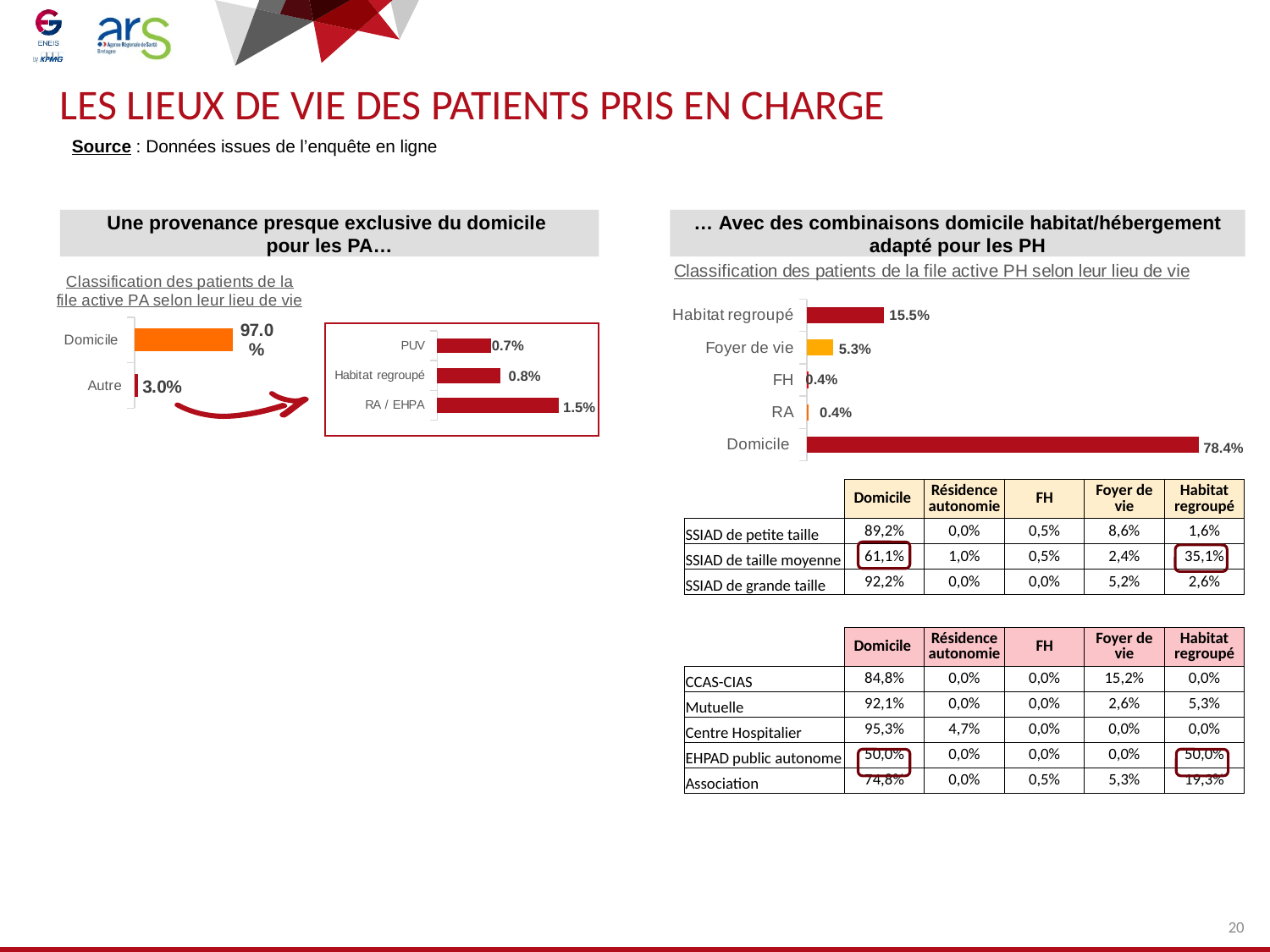
In the chart 'Classification des patients de la file active PA selon leur lieu de vie', what is the value for Autre? 3.0% In the chart 'Classification des patients de la file active PH selon leur lieu de vie', which category has the highest value? Domicile What kind of chart is 'Classification des patients de la file active PH selon leur lieu de vie'? Bar chart In the chart 'Classification des patients de la file active PA selon leur lieu de vie', what is the value for Domicile? 97.0% In the chart 'Classification des patients de la file active PH selon leur lieu de vie', what is the value for Foyer de vie? 5.3% In the small inset chart on the left, which is larger: Habitat regroupé or RA / EHPA? RA / EHPA In the chart 'Classification des patients de la file active PH selon leur lieu de vie', how many categories are shown? 5 In the chart 'Classification des patients de la file active PH selon leur lieu de vie', what is the value for Domicile? 78.4% In the small inset chart on the left (PUV, Habitat regroupé, RA / EHPA), which category has the highest value? RA / EHPA In the chart 'Classification des patients de la file active PH selon leur lieu de vie', what is the value for Habitat regroupé? 15.5% In the chart 'Classification des patients de la file active PH selon leur lieu de vie', what is the difference between Domicile and Habitat regroupé? 62.9% In the small inset chart on the left (PUV, Habitat regroupé, RA / EHPA), what is the value for PUV? 0.7%